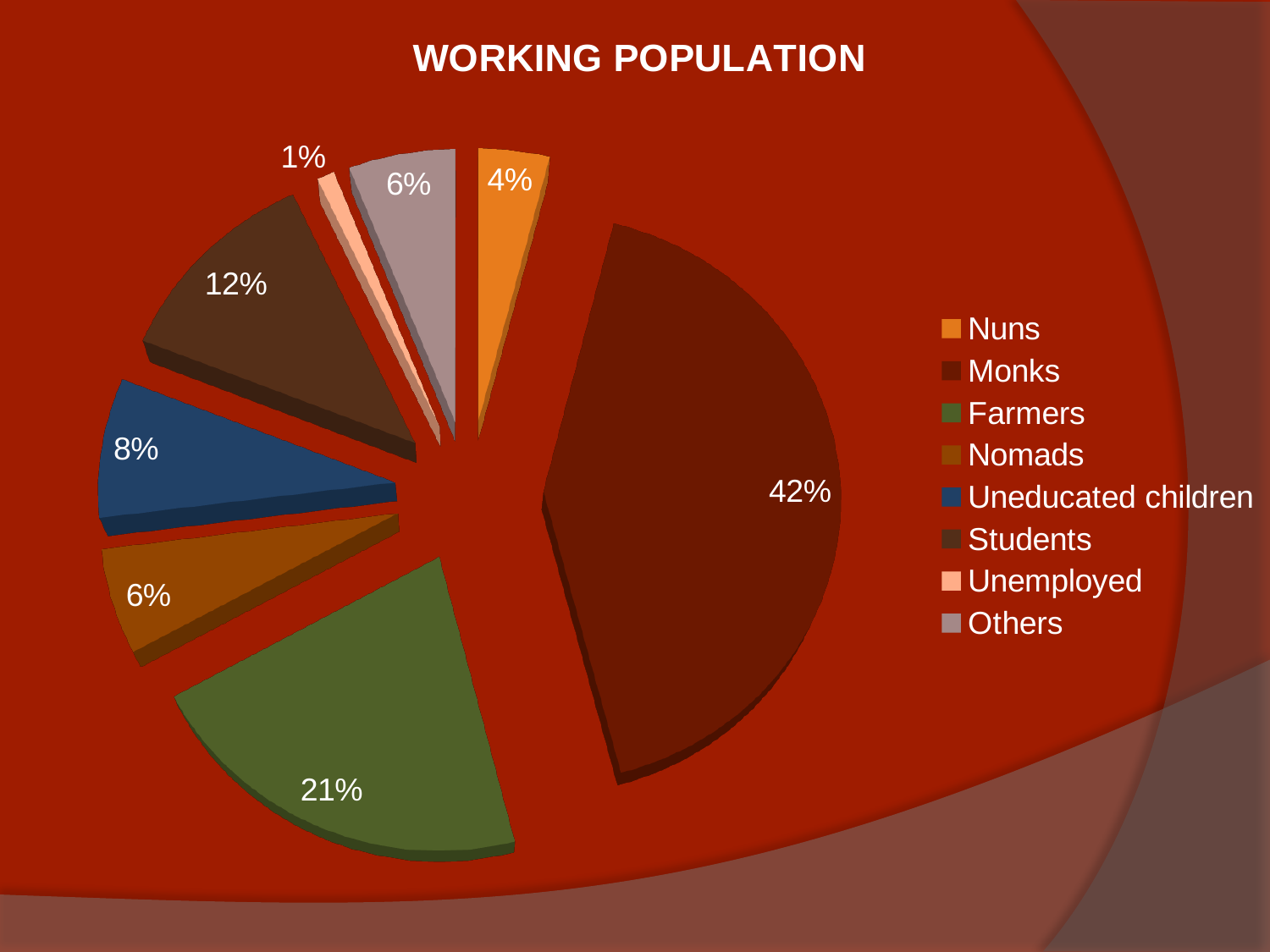
What share of the working population is Uneducated children? 8% What kind of chart is shown on the slide? pie chart Which category has the smallest share of the pie? Unemployed What share of the working population is Students? 12% What is the title of the chart? WORKING POPULATION How many categories does the legend list? 8 What share of the working population is Monks? 42% Which is larger, the share for Students or the share for Uneducated children? Students Which category has the largest share of the pie? Monks What share of the working population is Farmers? 21% What share of the working population is Nuns? 4% What is the difference in percentage points between Monks and Farmers? 21